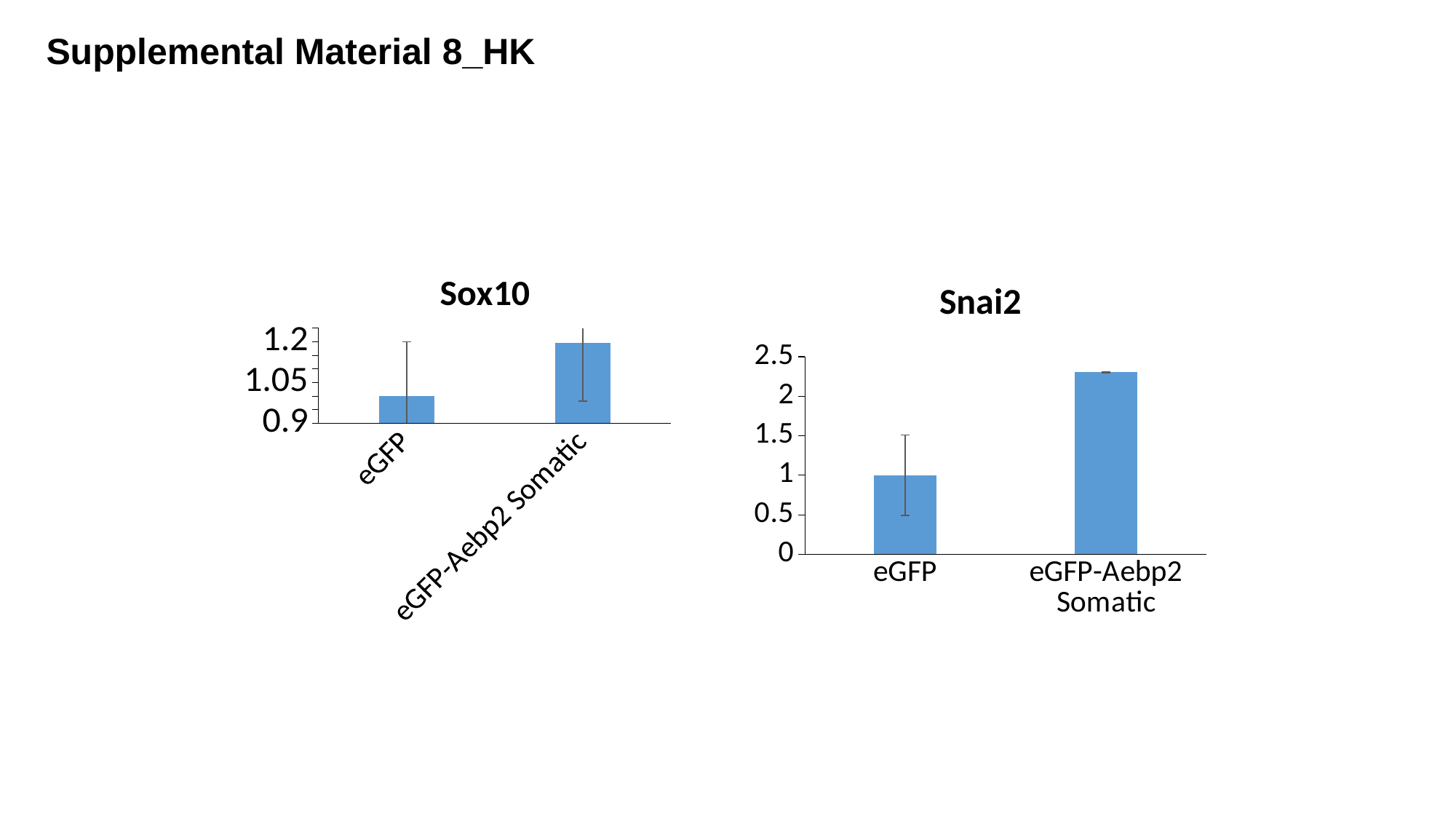
In the Snai2 chart, what is the value for eGFP? 1 What kind of chart is the Snai2 chart? bar chart What kind of chart is the Sox10 chart? bar chart In the Snai2 chart, which category has the lowest value? eGFP In the Sox10 chart, which category has the highest value? eGFP-Aebp2 Somatic In the Sox10 chart, is the value for eGFP-Aebp2 Somatic greater or less than 1.05? greater What is the title of the chart on the right side of the slide? Snai2 How many bars are shown in the Sox10 chart? 2 In the Sox10 chart, is the value for eGFP greater or less than 1.05? less In the Snai2 chart, which is larger, eGFP or eGFP-Aebp2 Somatic? eGFP-Aebp2 Somatic How many categories are shown in the Snai2 chart? 2 In the Snai2 chart, is the value for eGFP-Aebp2 Somatic greater or less than 2? greater